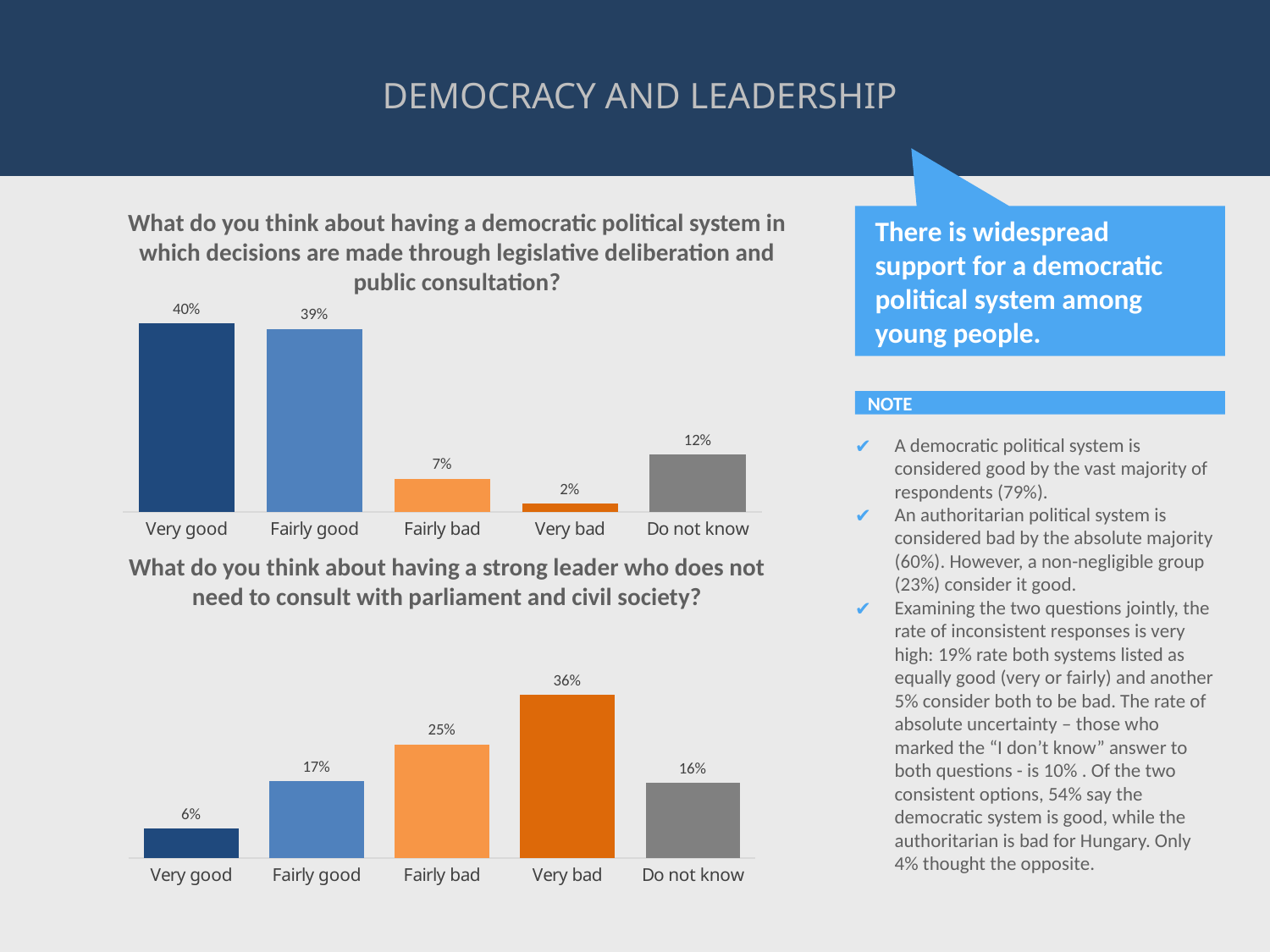
In the top chart about a democratic political system, what percentage answered "Do not know"? 12% In the top chart about a democratic political system, what colour is the "Very bad" bar? Dark orange In the bottom chart about a strong leader, what is the difference between "Fairly bad" and "Fairly good"? 8% In the bottom chart about a strong leader, what percentage answered "Very bad"? 36% In the top chart about a democratic political system, what percentage answered "Very good"? 40% In the bottom chart about a strong leader, which is larger: "Fairly bad" or "Do not know"? Fairly bad How many categories are shown in the top chart about a democratic political system? 5 In the top chart about a democratic political system, which category has the lowest value? Very bad In the bottom chart about a strong leader, which category has the highest value? Very bad What type of chart is the bottom chart about a strong leader? Bar chart In the top chart about a democratic political system, what is the difference between "Fairly good" and "Fairly bad"? 32% In the bottom chart about a strong leader, what percentage answered "Very good"? 6%